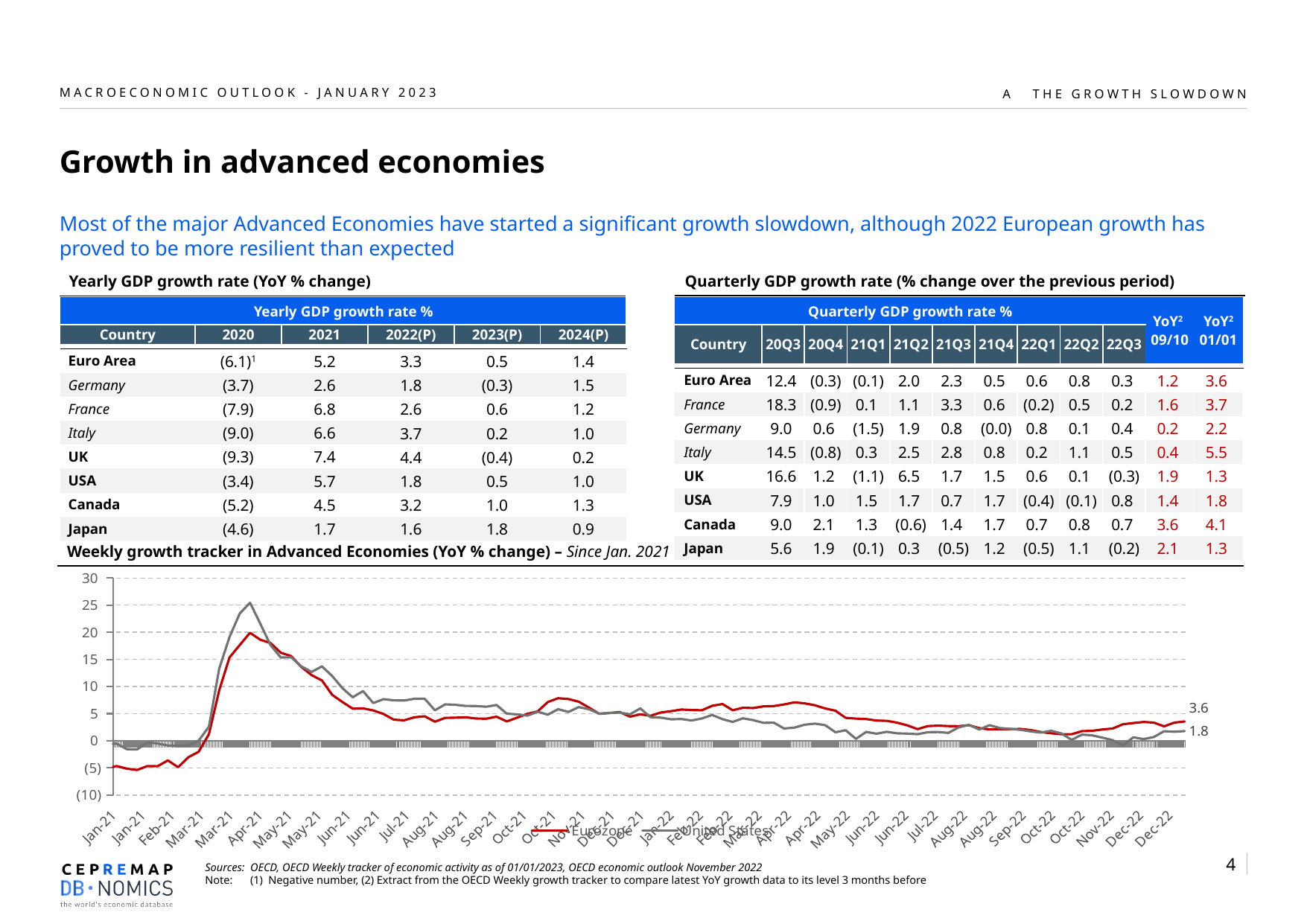
In the weekly growth tracker chart, do the values generally rise or fall from Apr-21 to Dec-22? fall In the weekly growth tracker chart, what is the difference between the latest labelled values of the Eurozone (3.6) and the United States (1.8)? 1.8 In the weekly growth tracker chart, what is the latest value labelled for the Eurozone line? 3.6 In the weekly growth tracker chart, which series has the higher latest labelled value, Eurozone or United States? Eurozone In the weekly growth tracker chart, is the Eurozone value in Jan-21 greater or less than 0? less How many series does the legend of the weekly growth tracker chart list? 2 In the weekly growth tracker chart, is the peak value of the United States line greater or less than 20? greater In the weekly growth tracker chart, what is the latest value labelled for the United States line? 1.8 What kind of chart is the weekly growth tracker at the bottom of the slide? line chart In the weekly growth tracker chart, which series reaches the higher peak in spring 2021? United States In the weekly growth tracker chart, is the peak value of the Eurozone line greater or less than 25? less In the weekly growth tracker chart, which colour is used for the Eurozone line? red